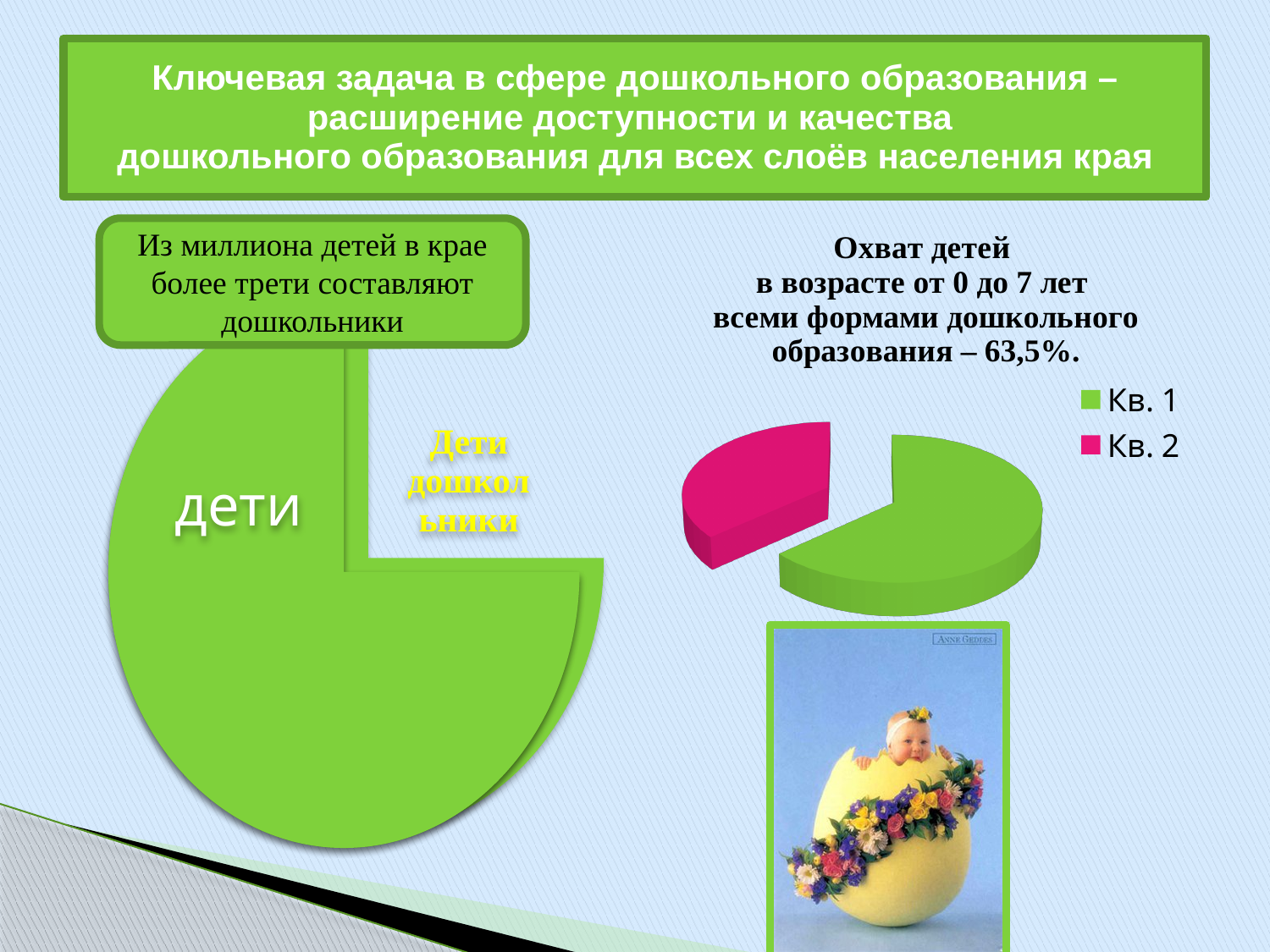
What colour is the Кв. 2 slice in the right-hand pie chart? pink In the right-hand pie chart, which slice is larger, Кв. 1 or Кв. 2? Кв. 1 What kind of chart is the chart on the right of the slide with the legend Кв. 1 and Кв. 2? pie chart How many entries does the legend of the right-hand pie chart list? 2 In the right-hand pie chart, which category has the largest slice? Кв. 1 In the right-hand pie chart, which category has the smallest slice? Кв. 2